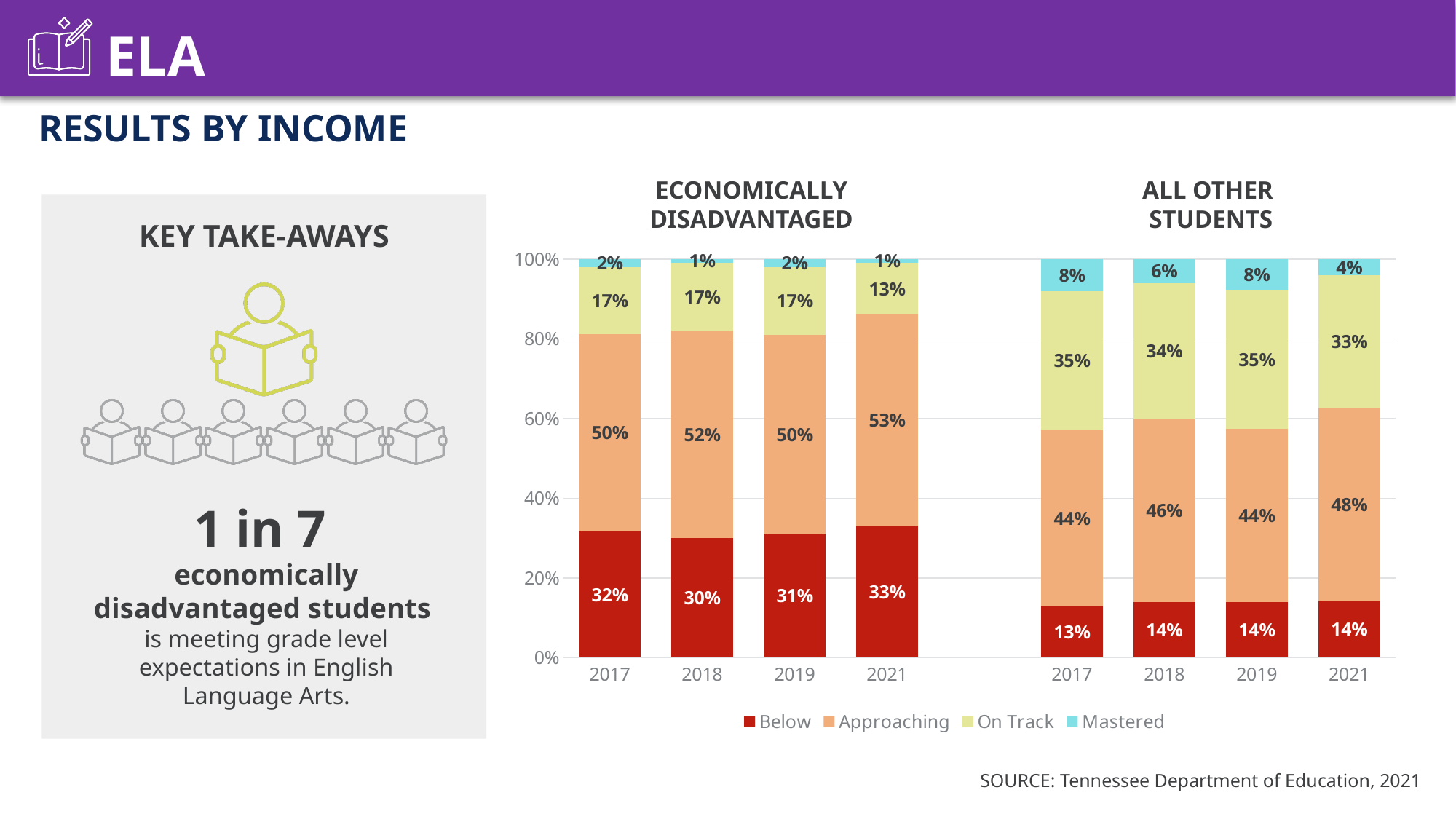
Among the economically disadvantaged bars, which year has the highest Approaching percentage? 2021 What percentage of economically disadvantaged students were Mastered in 2019? 2% What percentage of economically disadvantaged students were Below in 2021? 33% What is the difference between the On Track percentage for all other students and for economically disadvantaged students in 2017? 18% Which colour represents the Mastered category in the chart? Light blue How many years are shown for the economically disadvantaged group? 4 What percentage of all other students were On Track in 2018? 34% What kind of chart is shown on the slide? Stacked bar chart How many series does the legend list? 4 What is the combined On Track and Mastered percentage for economically disadvantaged students in 2021? 14% In 2018, which group has the larger Below percentage: economically disadvantaged students or all other students? Economically disadvantaged students Among the all other students bars, which year has the lowest Mastered percentage? 2021